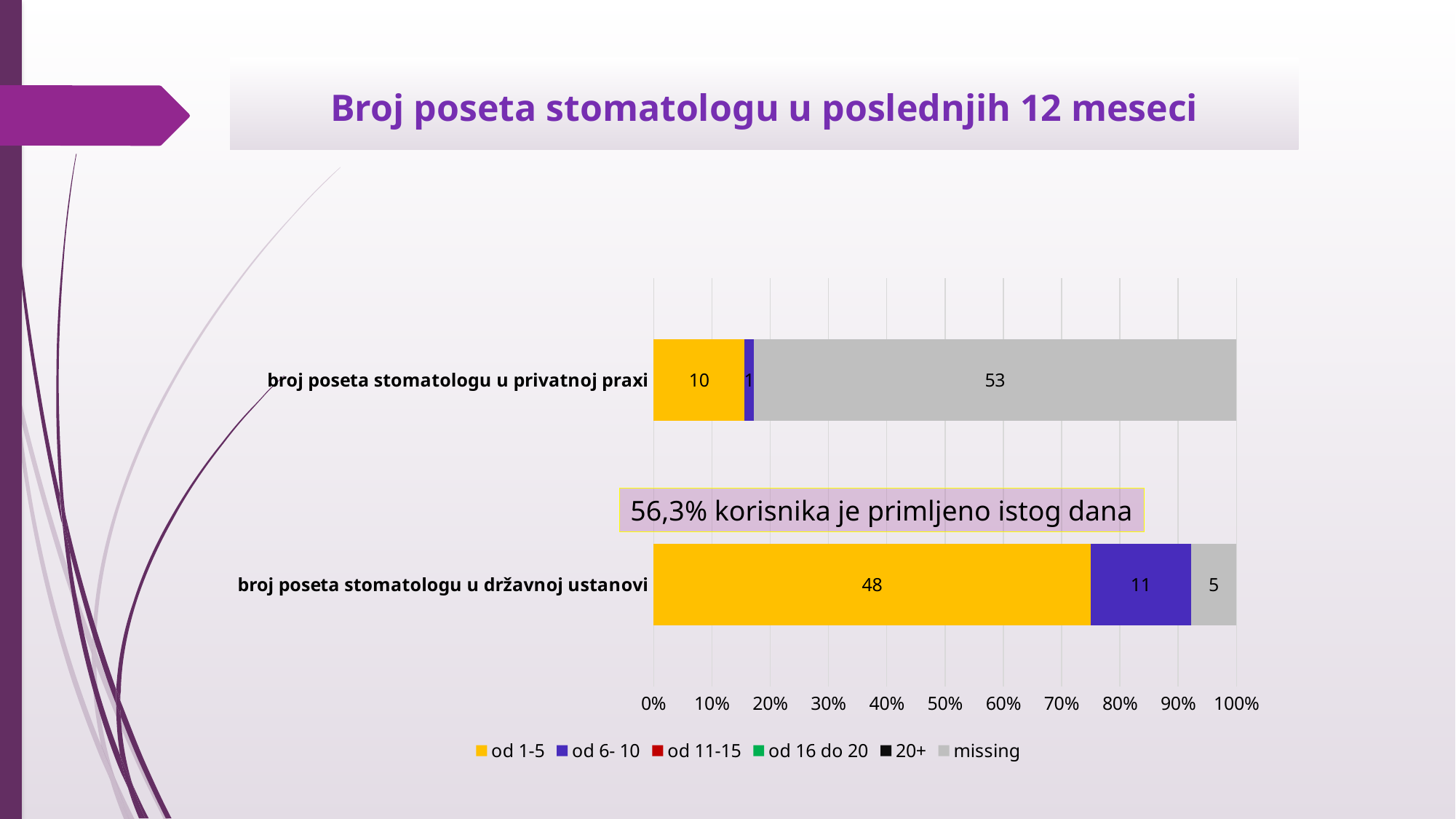
What is the value of the 'missing' series for 'broj poseta stomatologu u privatnoj praxi'? 53 What is the value of the 'od 1-5' series for 'broj poseta stomatologu u privatnoj praxi'? 10 How many series does the legend list? 6 What is the value of the 'od 6- 10' series for 'broj poseta stomatologu u državnoj ustanovi'? 11 What is the total of the stacked bar for 'broj poseta stomatologu u državnoj ustanovi'? 64 What kind of chart is shown on the slide? stacked bar chart Is the share of the 'od 1-5' segment in the 'broj poseta stomatologu u državnoj ustanovi' bar greater or less than 70%? greater What is the title of the slide? Broj poseta stomatologu u poslednjih 12 meseci What is the difference between the 'od 1-5' values for 'broj poseta stomatologu u državnoj ustanovi' and 'broj poseta stomatologu u privatnoj praxi'? 38 Which category has the larger 'missing' value, 'broj poseta stomatologu u privatnoj praxi' or 'broj poseta stomatologu u državnoj ustanovi'? broj poseta stomatologu u privatnoj praxi What is the value of the 'od 1-5' series for 'broj poseta stomatologu u državnoj ustanovi'? 48 How many categories are shown on the chart? 2